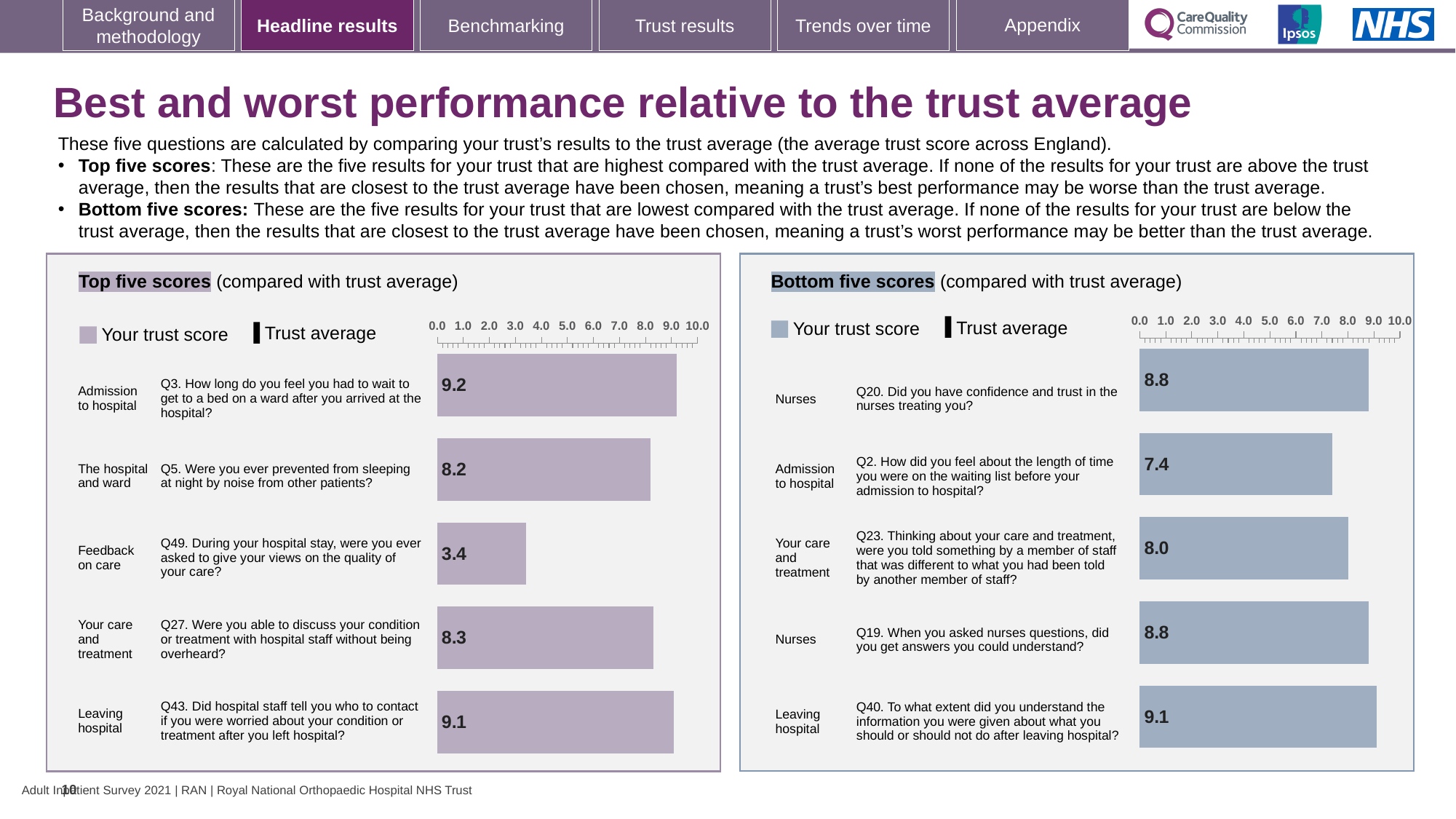
In the Top five scores chart, what is the trust score for Q3 (how long you had to wait to get to a bed on a ward)? 9.2 What kind of chart is used in the Bottom five scores panel? Bar chart In the Bottom five scores chart, which question has the highest trust score? Q40 In the Bottom five scores chart, which question has the lowest trust score? Q2 In the Top five scores chart, which question has the highest trust score? Q3 In the Top five scores chart, which question has the lowest trust score? Q49 In the Top five scores chart, what is the difference between the trust scores for Q3 and Q49? 5.8 In the Bottom five scores chart, what is the difference between the trust scores for Q40 and Q2? 1.7 In the Bottom five scores chart, what is the trust score for Q2 (length of time on the waiting list before admission)? 7.4 In the Bottom five scores chart, which has the larger trust score, Q23 or Q19? Q19 How many questions are plotted in the Top five scores chart? 5 In the Top five scores chart, what is the trust score for Q49 (asked to give your views on the quality of your care)? 3.4